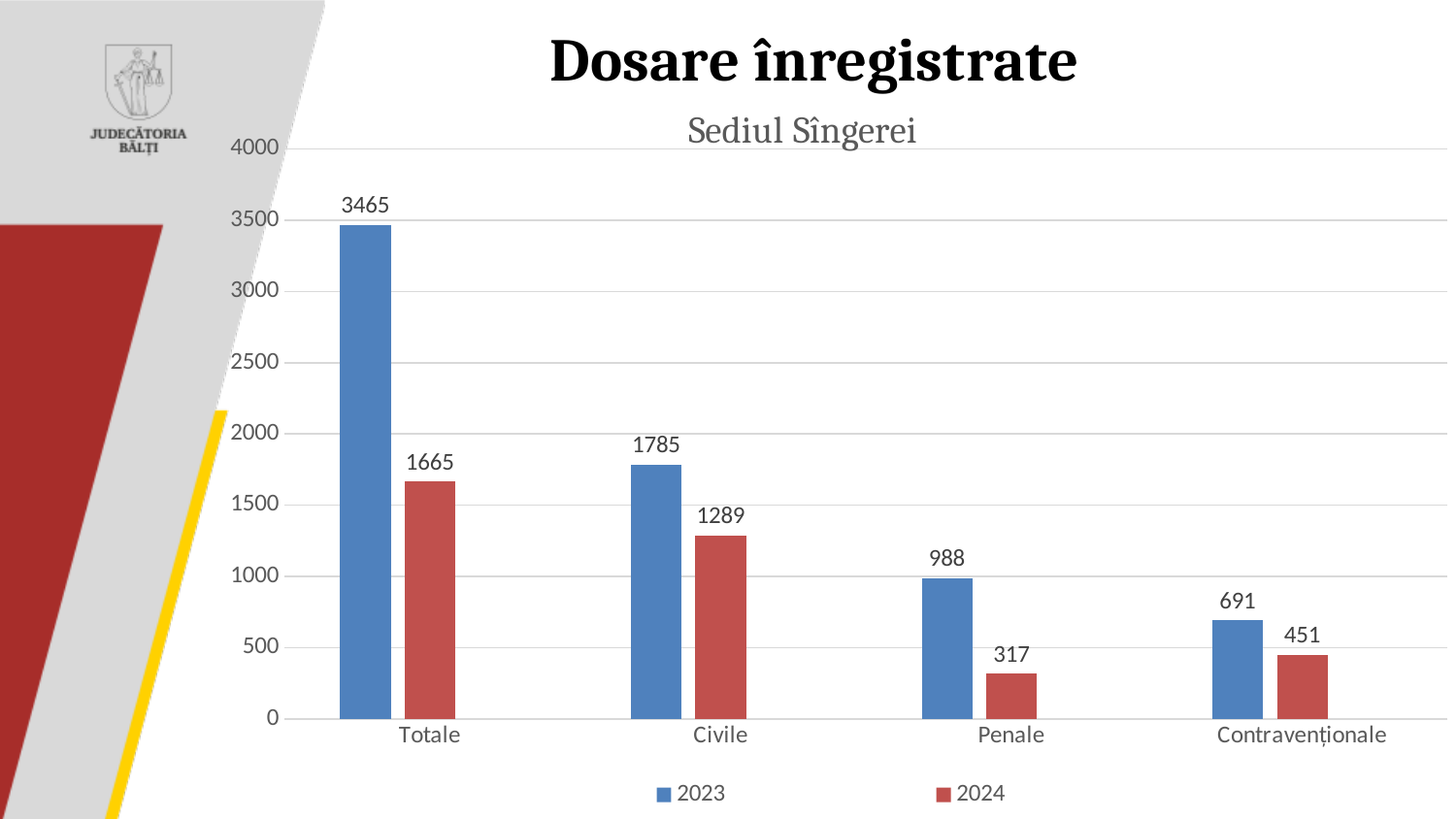
What kind of chart is shown on the slide? Bar chart What is the value for Totale in the 2023 series? 3465 What is the value for Penale in the 2024 series? 317 What is the subtitle shown below the chart title? Sediul Sîngerei What is the value for Contravenționale in the 2023 series? 691 How many categories are shown on the x axis? 4 What is the difference between the 2023 and 2024 values for Civile? 496 Which category has the lowest value in the 2024 series? Penale Which category has the highest value in the 2023 series? Totale How many series does the legend list? 2 What is the difference between the 2023 and 2024 values for Totale? 1800 Which is larger: the 2024 value for Civile or the 2023 value for Penale? 2024 value for Civile